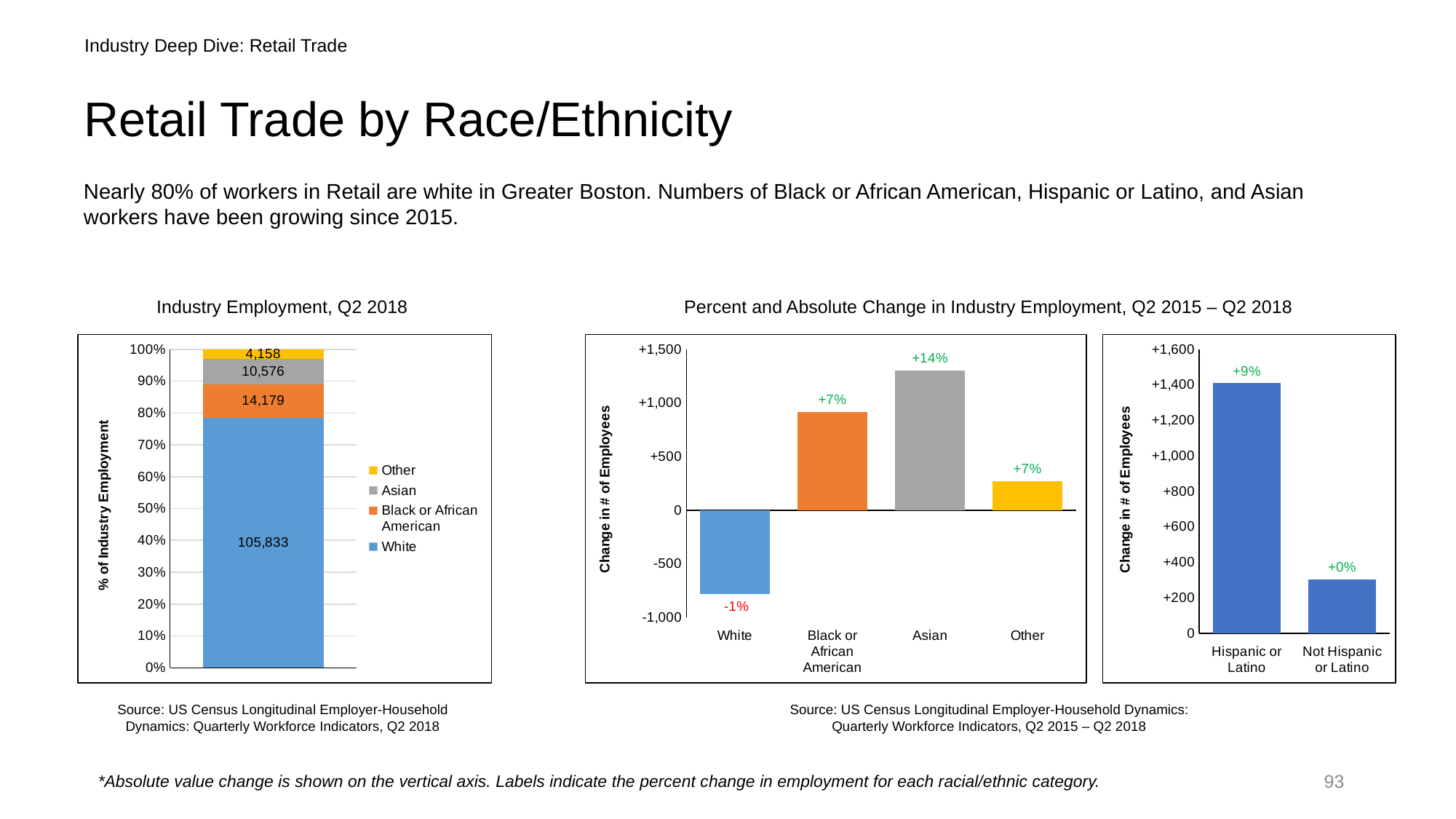
In the 'Industry Employment, Q2 2018' chart, what is the value for White? 105,833 In the middle chart (Percent and Absolute Change in Industry Employment by race), what percent change label is shown for Asian? +14% In the right chart (Hispanic or Latino vs Not Hispanic or Latino), is the value for Not Hispanic or Latino greater or less than +400? less In the 'Industry Employment, Q2 2018' chart, what is the total of the stacked bar? 134,746 In the middle chart (Percent and Absolute Change in Industry Employment by race), is the value for White greater or less than -500? less In the right chart (Hispanic or Latino vs Not Hispanic or Latino), what percent change label is shown for Hispanic or Latino? +9% In the middle chart (Percent and Absolute Change in Industry Employment by race), what percent change label is shown for White? -1% In the middle chart (Percent and Absolute Change in Industry Employment by race), how many categories are shown on the x axis? 4 In the 'Industry Employment, Q2 2018' chart, which is larger, Asian or Other? Asian In the 'Industry Employment, Q2 2018' chart, how many series does the legend list? 4 In the middle chart (Percent and Absolute Change in Industry Employment by race), which category has the highest change in number of employees? Asian In the 'Industry Employment, Q2 2018' chart, what is the value for Black or African American? 14,179